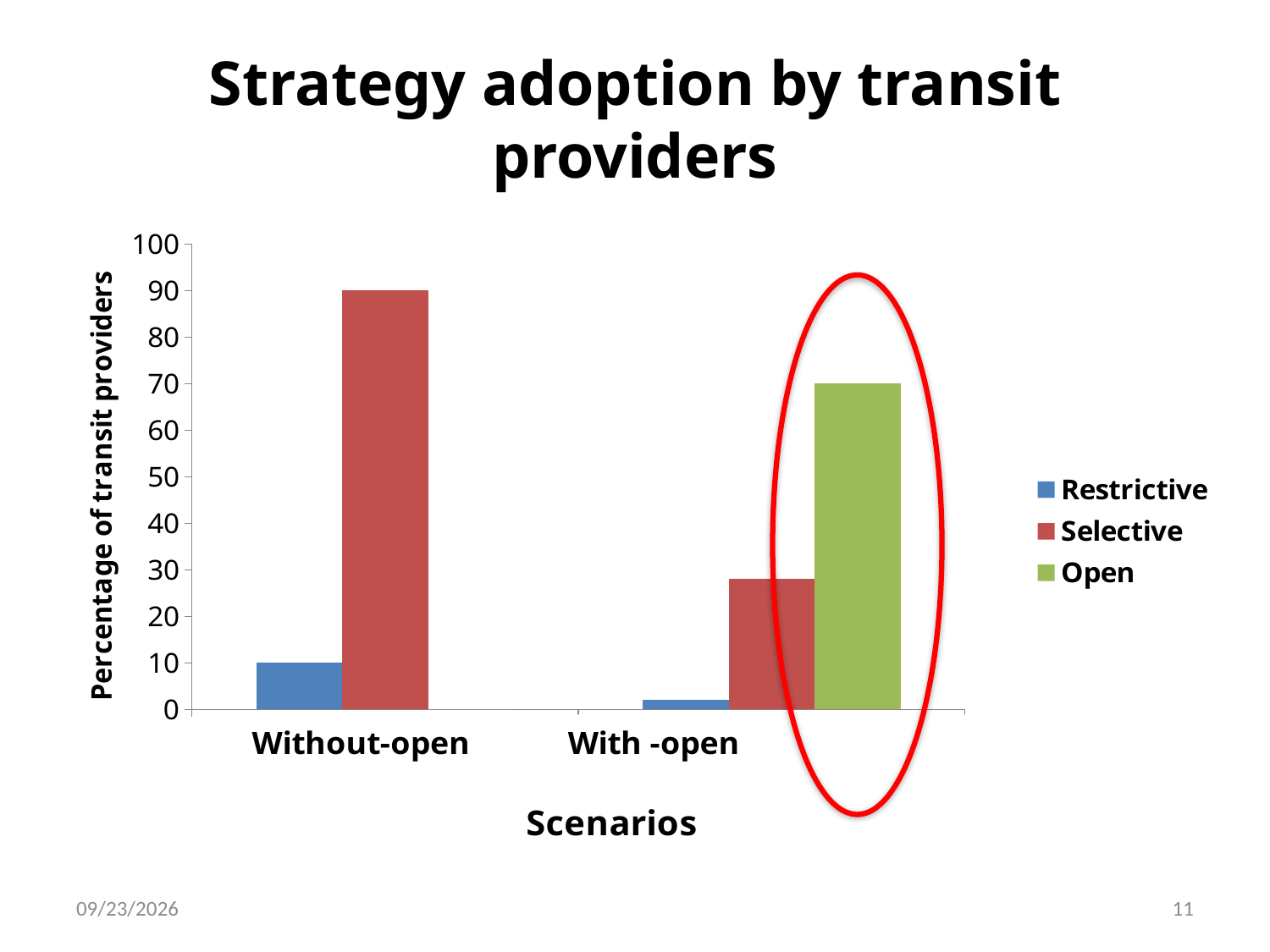
Which series has the highest value in the Without-open scenario? Selective How many series does the legend list? 3 What type of chart is shown on the slide? Bar chart Which series has the lowest value in the With -open scenario? Restrictive What is the percentage of transit providers for Selective in the Without-open scenario? 90 Is the value for Selective in the With -open scenario greater or less than 30? less What is the percentage of transit providers for Open in the With -open scenario? 70 Which is larger: Selective in the Without-open scenario or Selective in the With -open scenario? Selective in the Without-open scenario What is the percentage of transit providers for Restrictive in the Without-open scenario? 10 Which series is highlighted with a red ellipse on the chart? Open What is the difference between the Selective value in the Without-open scenario and the Open value in the With -open scenario? 20 How many scenario categories are shown on the x axis? 2